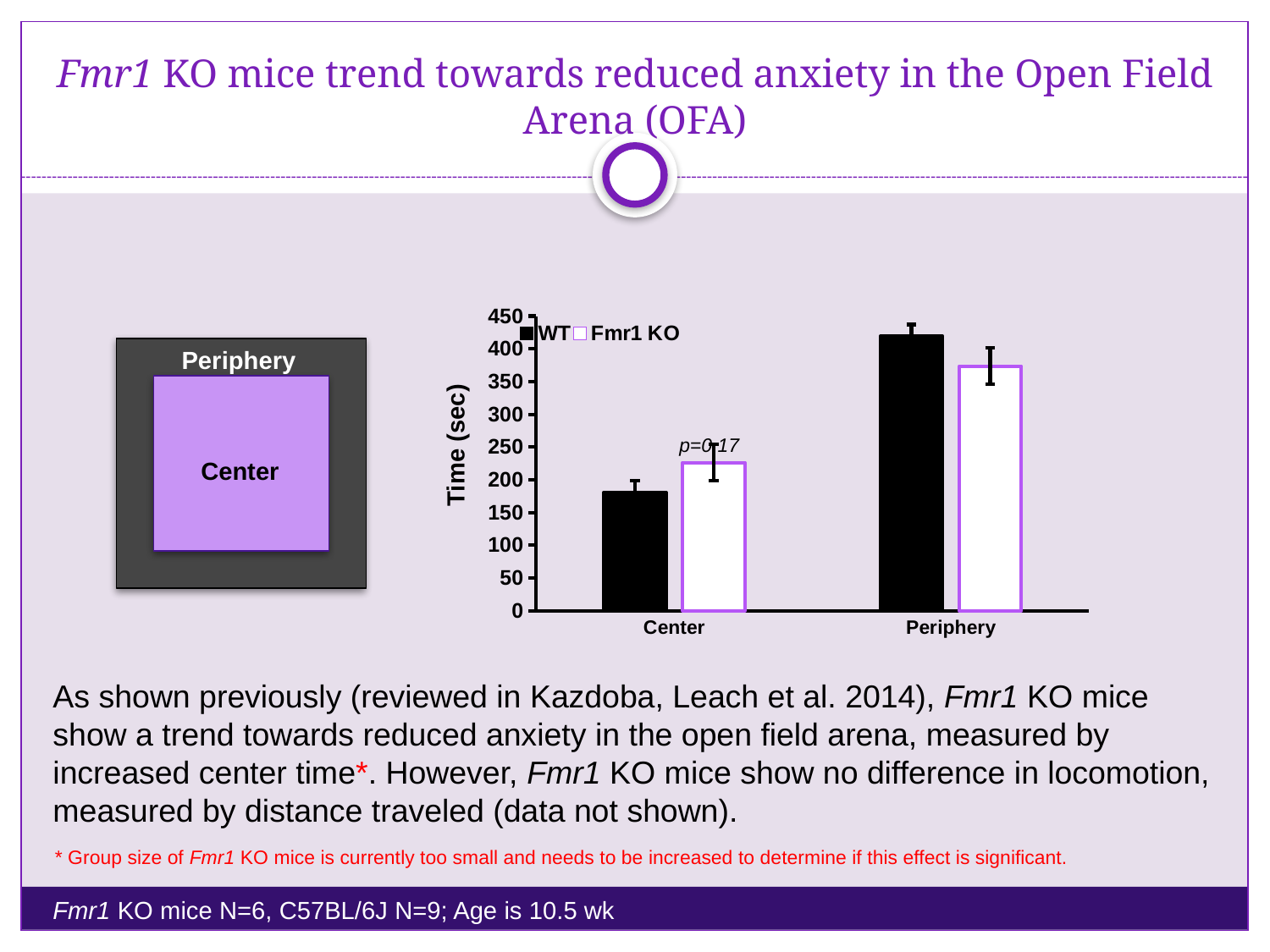
Is the Fmr1 KO value for Periphery greater or less than 400? less What is the label of the y axis of the chart? Time (sec) How many series does the chart's legend list? 2 Is the Fmr1 KO value for Center greater or less than 200? greater What are the two series named in the chart's legend? WT and Fmr1 KO What kind of chart is shown on the slide? bar chart How many categories are shown on the x axis of the chart? 2 For the Center category, which series has the larger value, WT or Fmr1 KO? Fmr1 KO Which bar in the chart is the highest? WT Periphery For the Periphery category, which series has the larger value, WT or Fmr1 KO? WT Is the WT value for Periphery greater or less than 400? greater